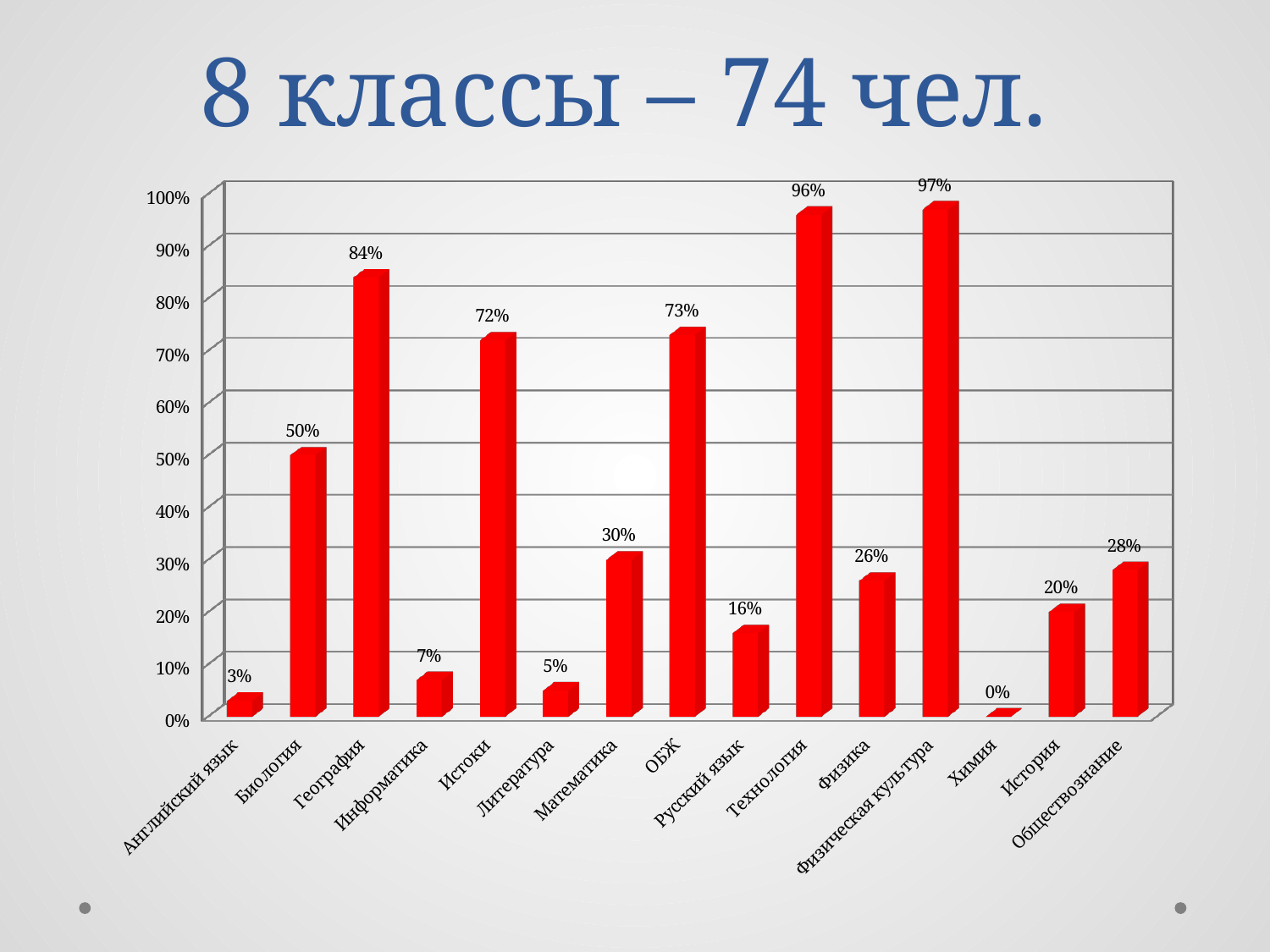
Which category has the highest value? Физическая культура What is the title of the slide? 8 классы – 74 чел. How many categories are shown on the x axis? 15 What is the difference between the values for Технология and Биология? 46% What is the value for Истоки? 72% What is the value for География? 84% Which is larger, the value for ОБЖ or the value for Математика? ОБЖ What is the value for Русский язык? 16% Which category has the lowest value? Химия What kind of chart is shown on the slide? bar chart Is the value for Обществознание greater or less than 20%? greater What colour are the bars in the chart? red